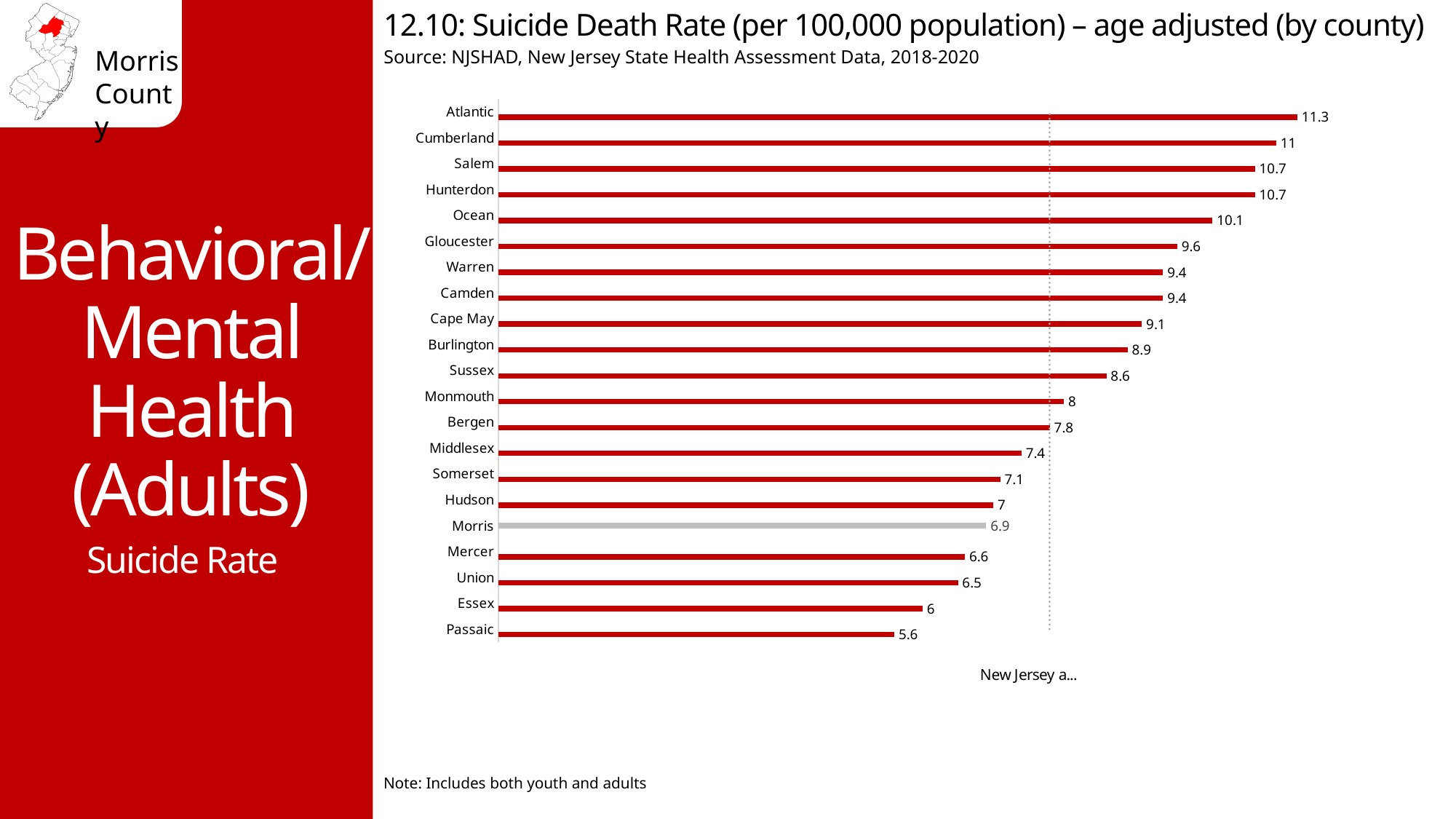
Which county has a higher suicide death rate, Morris or Bergen? Bergen Which county's bar is shown in grey instead of red? Morris Which county has the highest suicide death rate? Atlantic What is the suicide death rate for Morris County? 6.9 Which county has the lowest suicide death rate? Passaic Which county has a higher suicide death rate, Ocean or Gloucester? Ocean What is the suicide death rate for Atlantic County? 11.3 What is the difference between the suicide death rates of Morris and Hudson counties? 0.1 What is the difference between the suicide death rates of Atlantic and Passaic counties? 5.7 What is the suicide death rate for Passaic County? 5.6 How many counties are shown in the chart? 21 What kind of chart is shown on the slide? Bar chart